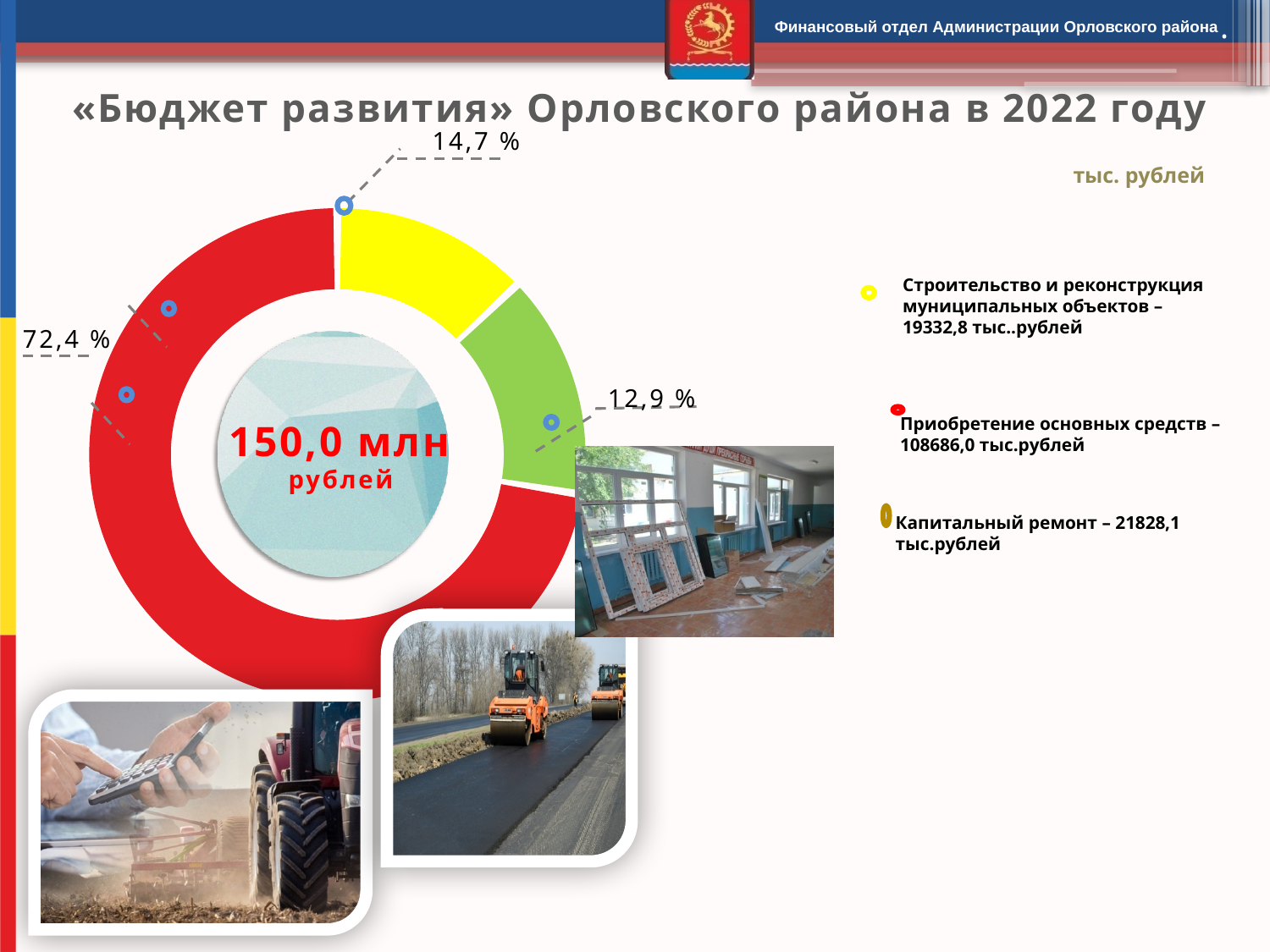
What kind of chart is shown on the slide? pie (donut) chart What is the largest percentage share labelled on the pie chart? 72,4 % What share of the pie does the red slice represent? 72,4 % What total amount is shown in the centre of the pie chart? 150,0 млн рублей What amount is given for «Капитальный ремонт»? 21828,1 тыс.рублей Which category has the largest amount: «Приобретение основных средств», «Капитальный ремонт» or «Строительство и реконструкция муниципальных объектов»? Приобретение основных средств What is the smallest percentage share labelled on the pie chart? 12,9 % What is the difference between the amounts for «Приобретение основных средств» and «Капитальный ремонт»? 86857,9 тыс.рублей What amount is given for «Приобретение основных средств»? 108686,0 тыс.рублей How many slices does the pie chart have? 3 What amount is given for «Строительство и реконструкция муниципальных объектов»? 19332,8 тыс..рублей Which is larger, the amount for «Капитальный ремонт» or for «Строительство и реконструкция муниципальных объектов»? Капитальный ремонт